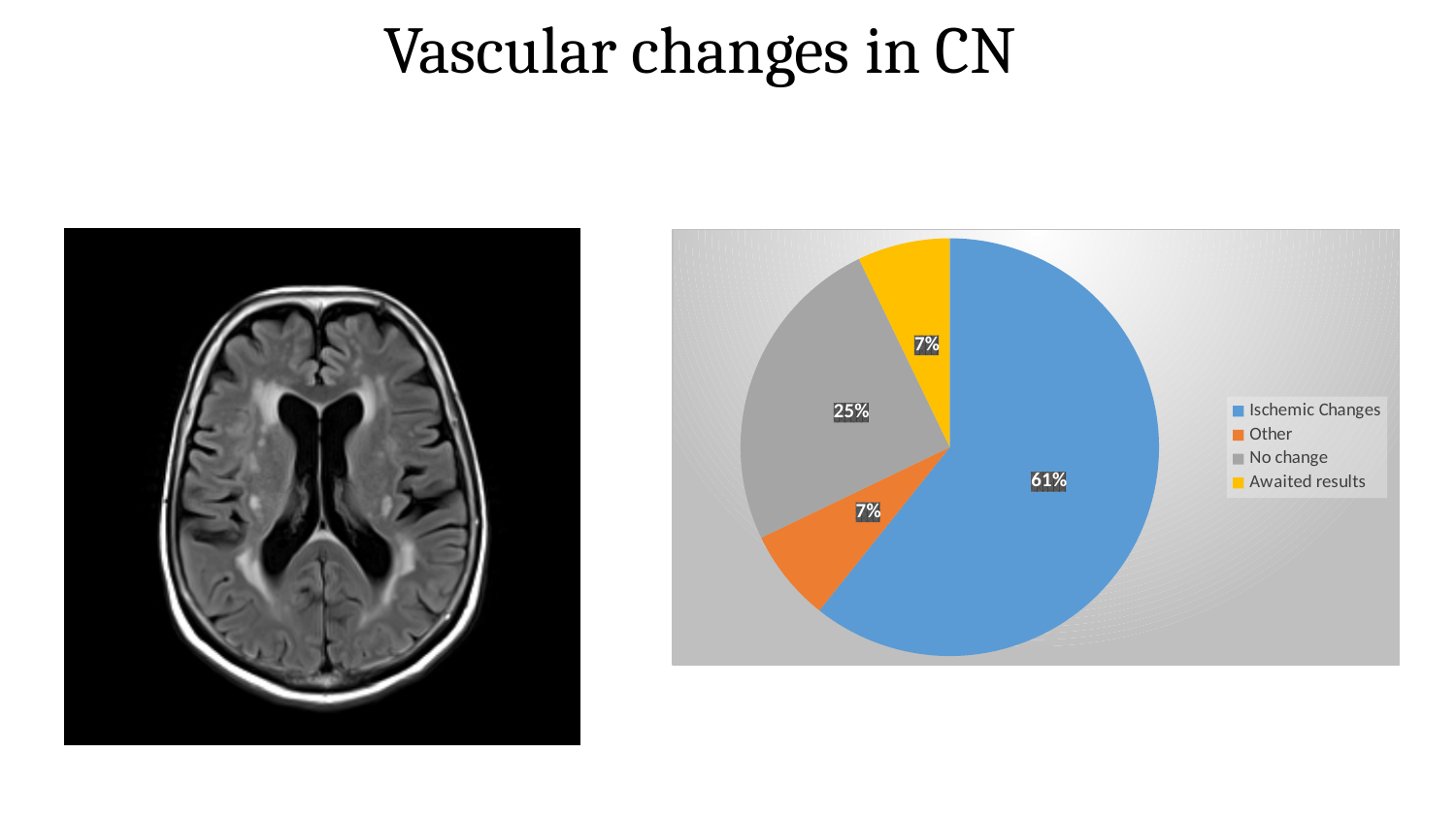
What is the difference in percentage points between Ischemic Changes and No change? 36 What kind of chart is shown on the slide? pie chart Which is larger, the share for No change or the share for Other? No change What share of the pie is labelled Ischemic Changes? 61% Which colour represents Awaited results in the pie chart? yellow How many slices does the pie chart have? 4 What share of the pie is labelled No change? 25% What is the difference in percentage points between No change and Awaited results? 18 What share of the pie is labelled Other? 7% How many entries does the legend list? 4 Which category has the largest slice of the pie? Ischemic Changes